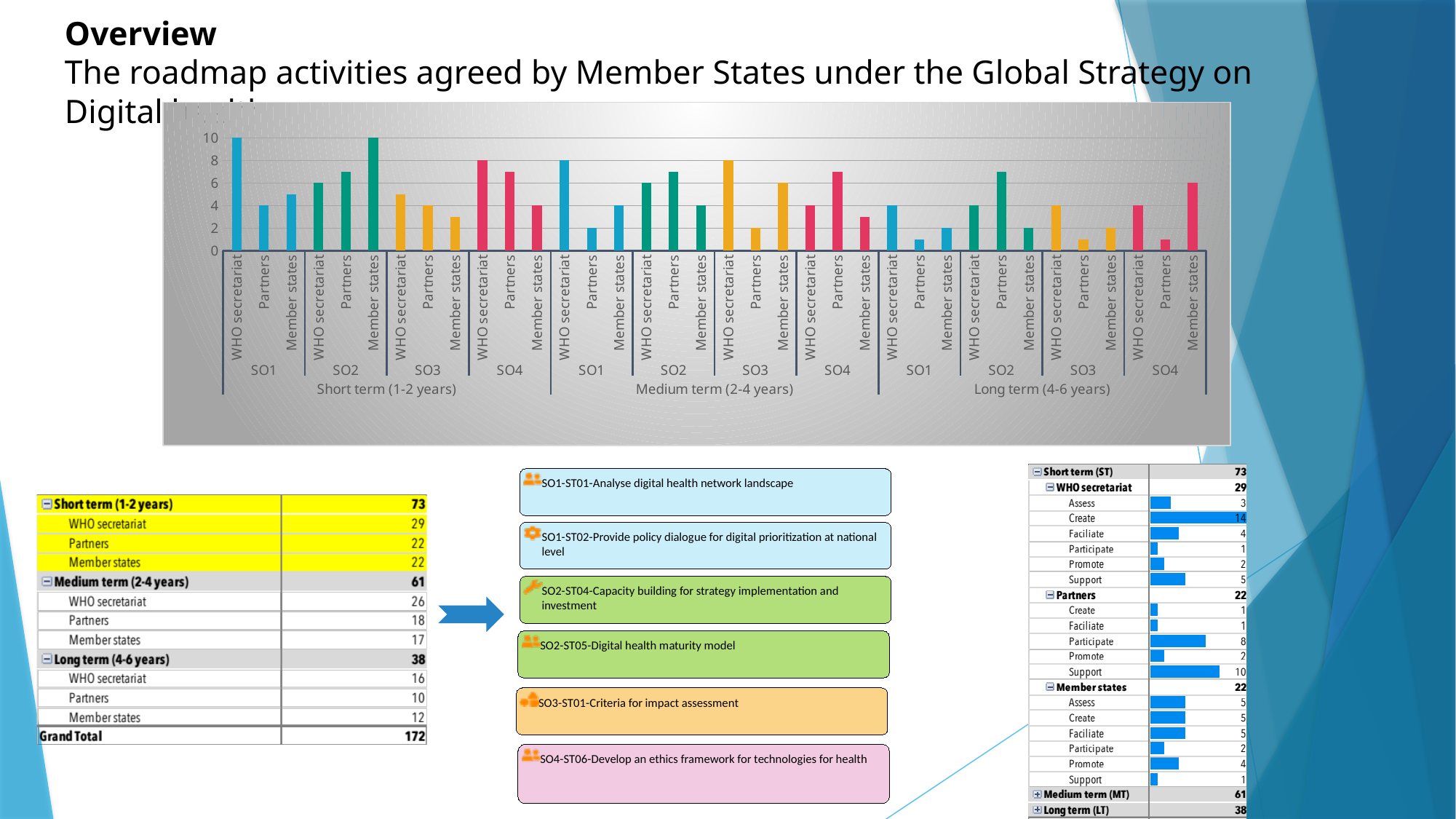
In the top chart, is the value for Partners under SO2 in the Short term (1-2 years) group greater or less than 6? greater In the data-bar chart on the right of the slide, which WHO secretariat activity has the highest value? Create In the top chart, what is the value for Member states under SO2 in the Short term (1-2 years) group? 10 In the top chart, which is larger in the Short term (1-2 years) SO1 group: WHO secretariat or Partners? WHO secretariat In the top chart, is the value for Member states under SO3 in the Short term (1-2 years) group greater or less than 4? less In the top chart, what is the value for Member states under SO3 in the Medium term (2-4 years) group? 6 What kind of chart is shown at the top of the slide? bar chart In the top chart, which bar is the highest within the Long term (4-6 years) group? Partners under SO2 In the top chart, what is the difference between WHO secretariat and Partners under SO1 in the Short term (1-2 years) group? 6 In the top chart, what is the value for WHO secretariat under SO1 in the Medium term (2-4 years) group? 8 How many time-horizon groups are shown along the x axis of the top chart? 3 In the top chart, what is the value for WHO secretariat under SO1 in the Short term (1-2 years) group? 10